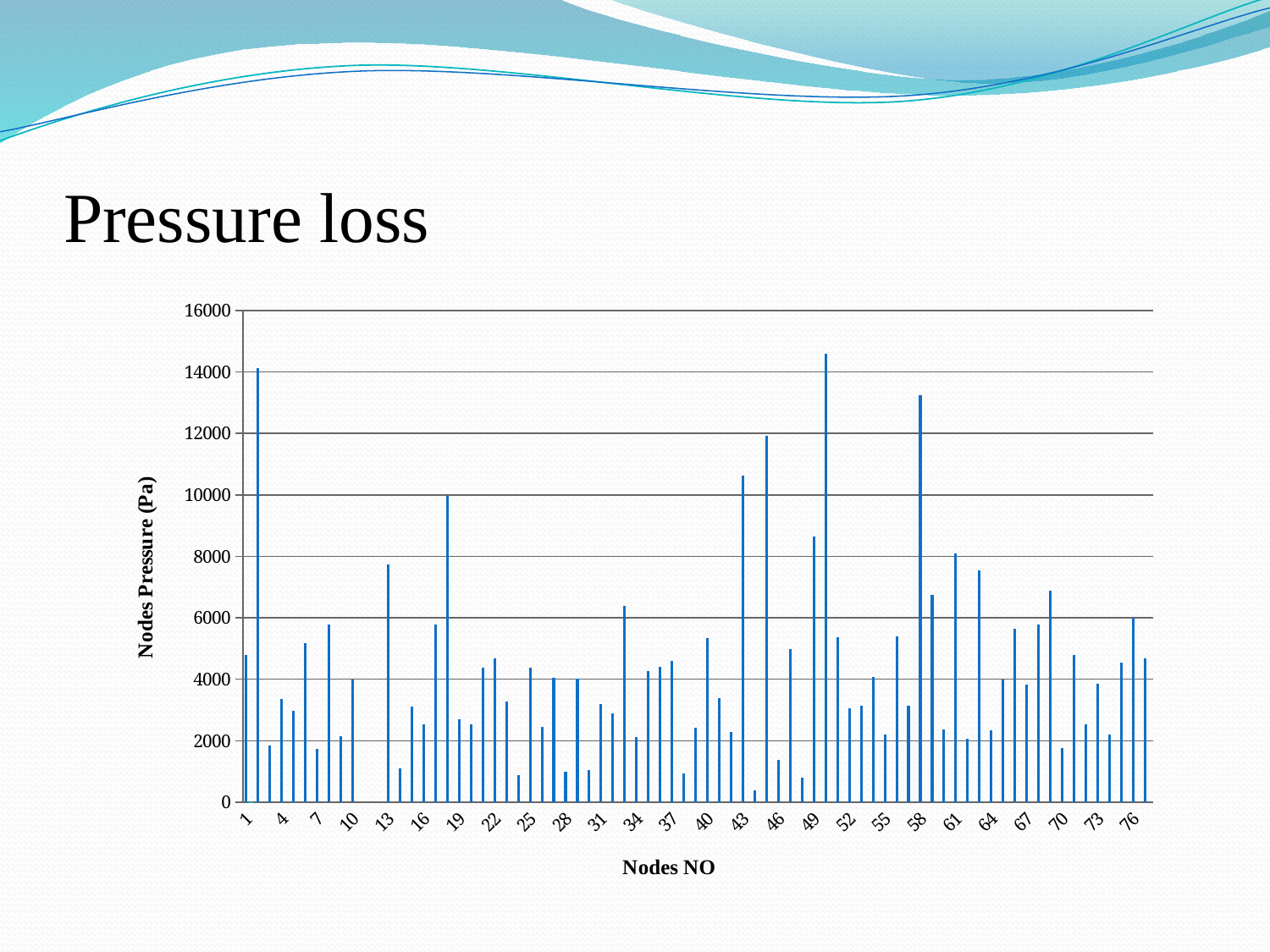
Is the value for node 58 greater or less than 12000? greater What is the highest value shown on the y axis of the chart? 16000 Is the value for node 4 greater or less than 4000? less Is the value for node 61 greater or less than 6000? greater What kind of chart is shown on the slide? bar chart What is the title of the y axis of the chart? Nodes Pressure (Pa) What is the title of the x axis of the chart? Nodes NO